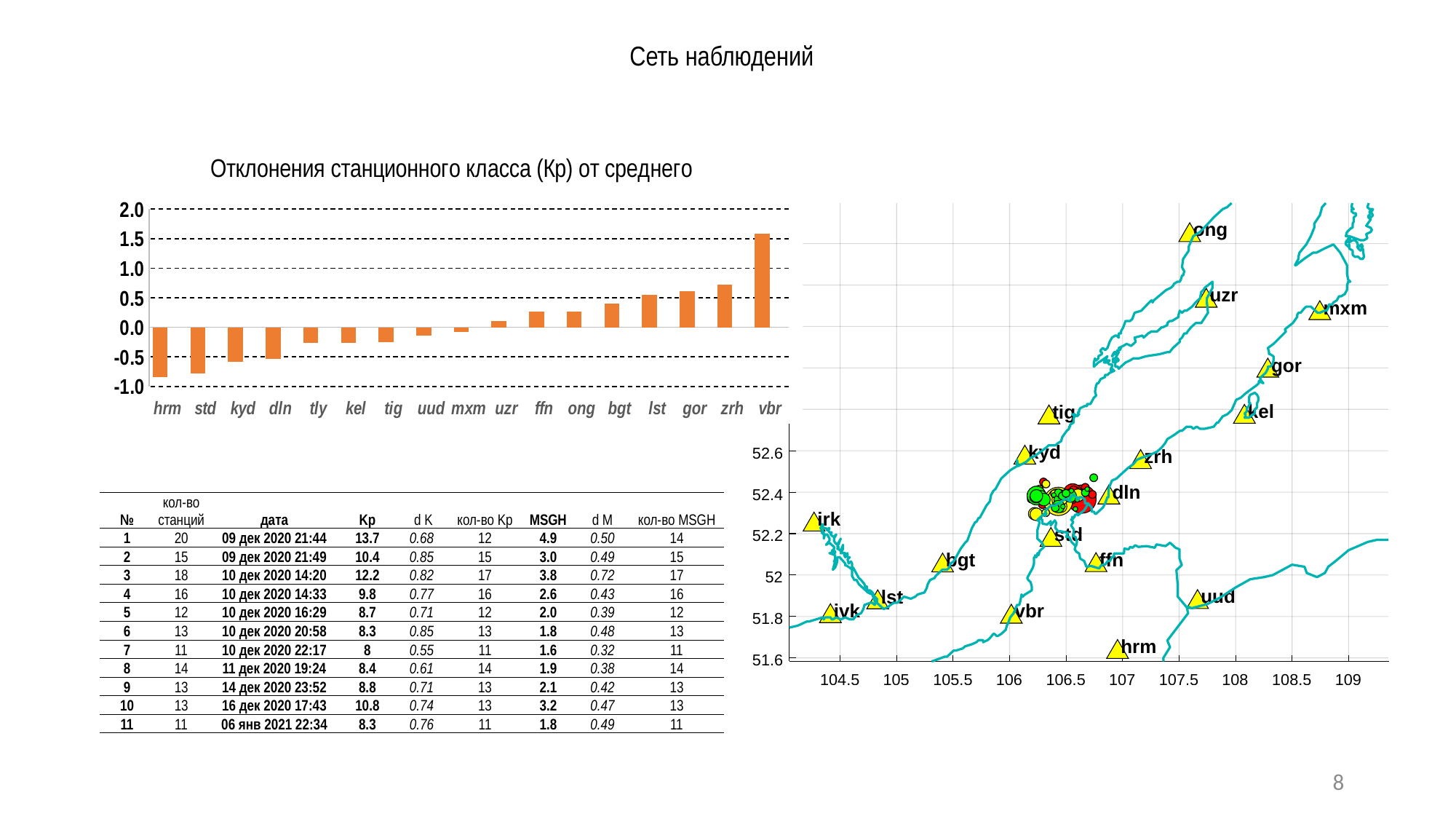
Which has the larger value in the bar chart, hrm or tly? tly Which station has the highest value in the bar chart? vbr Is the value for tly greater or less than -0.5? greater Is the value for zrh greater or less than 0.5? greater Is the value for bgt greater or less than 0.5? less Do the bar values rise or fall from left to right along the x axis? rise What kind of chart is "Отклонения станционного класса (Кр) от среднего"? bar chart What is the title of the bar chart? Отклонения станционного класса (Кр) от среднего How many stations (categories) are shown on the x axis of the bar chart? 17 Which has the larger value in the bar chart, vbr or zrh? vbr